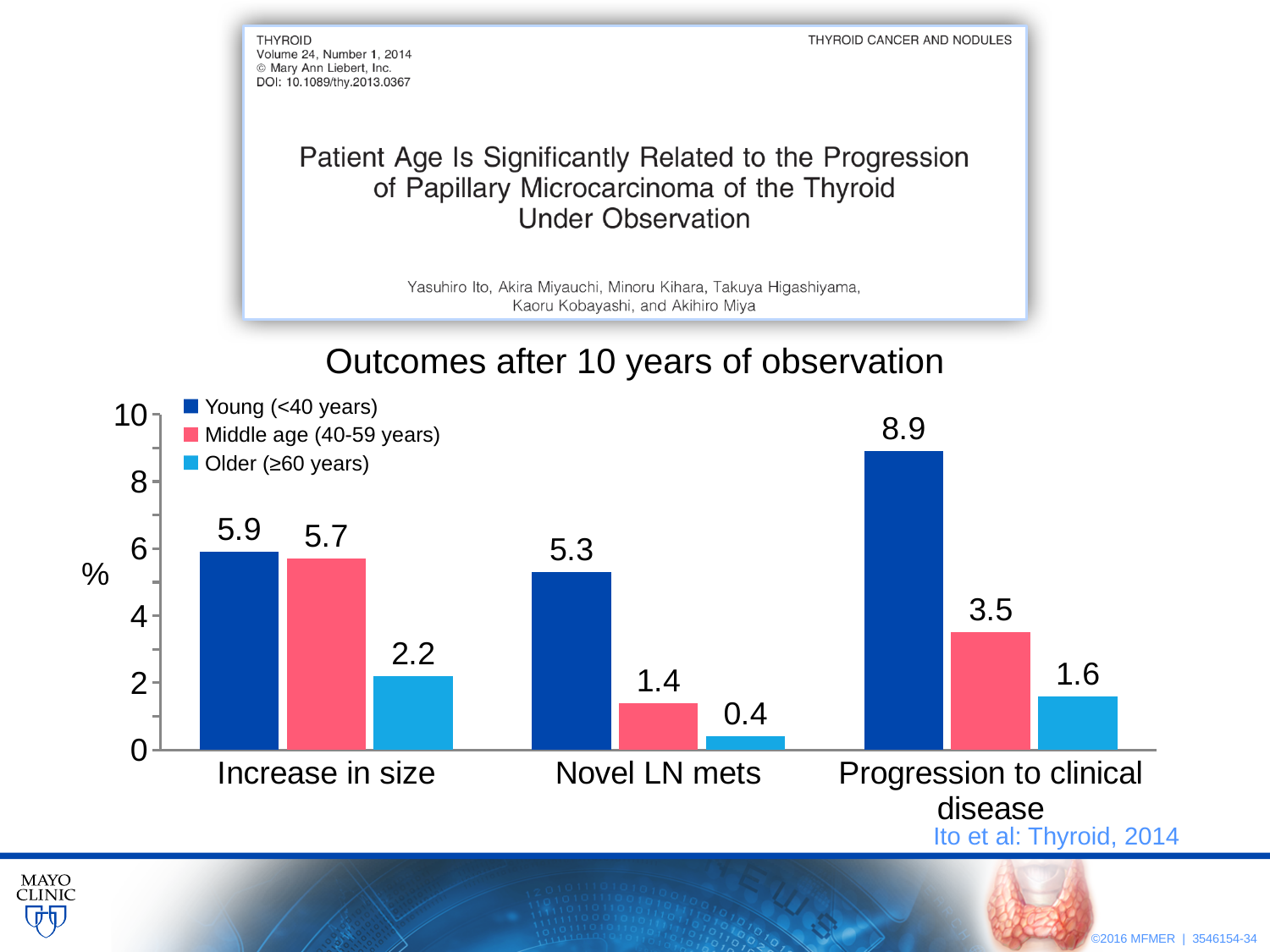
What is the difference between the Young (<40 years) and Older (≥60 years) values in the Progression to clinical disease category? 7.3 Which category has the highest value for the Young (<40 years) series? Progression to clinical disease What is the title of the chart? Outcomes after 10 years of observation How many series does the legend list? 3 Which category has the lowest value for the Older (≥60 years) series? Novel LN mets What is the value for Older (≥60 years) in the Novel LN mets category? 0.4 How many categories are shown on the x axis? 3 What kind of chart is shown on the slide? Bar chart What is the value for Young (<40 years) in the Progression to clinical disease category? 8.9 What is the label on the y axis? % What is the value for Middle age (40-59 years) in the Increase in size category? 5.7 Which is larger in the Novel LN mets category: the Young (<40 years) value or the Middle age (40-59 years) value? Young (<40 years)